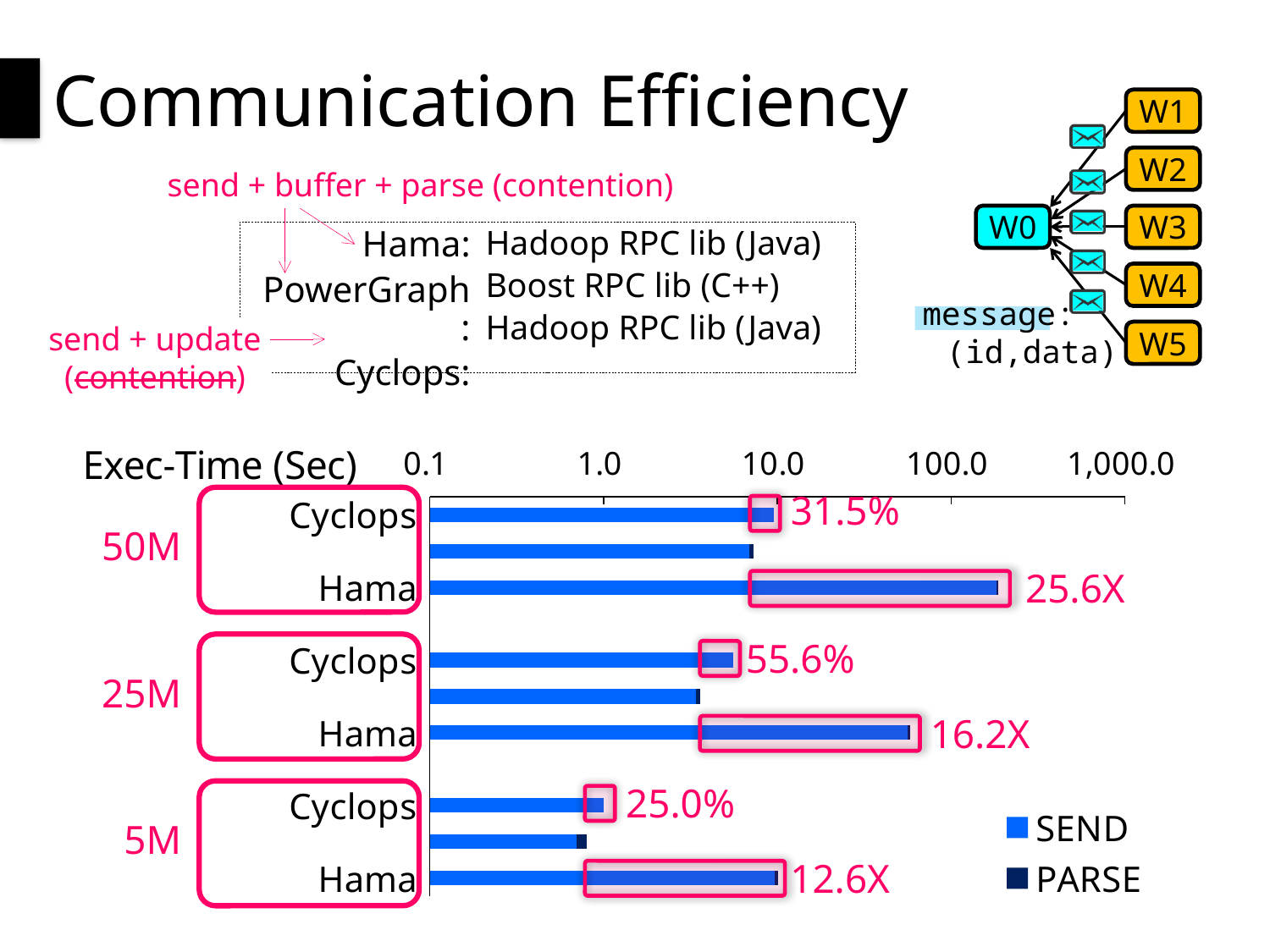
Which labeled bar in the chart has the longest total execution time? Hama (50M) What annotation is printed next to the Cyclops bar in the 25M group? 55.6% What is the label of the chart's x axis? Exec-Time (Sec) How many data-size groups (50M, 25M, 5M) are shown in the chart? 3 What kind of chart is shown on the slide? bar chart What annotation is printed next to the Hama bar in the 5M group? 12.6X What annotation is printed next to the Cyclops bar in the 5M group? 25.0% What are the two series named in the chart legend? SEND and PARSE What annotation is printed next to the Hama bar in the 50M group? 25.6X Is the total execution time for Hama in the 50M group greater or less than 100.0 seconds? greater How many series does the chart legend list? 2 In the 25M group, which has the larger total execution time, Cyclops or Hama? Hama